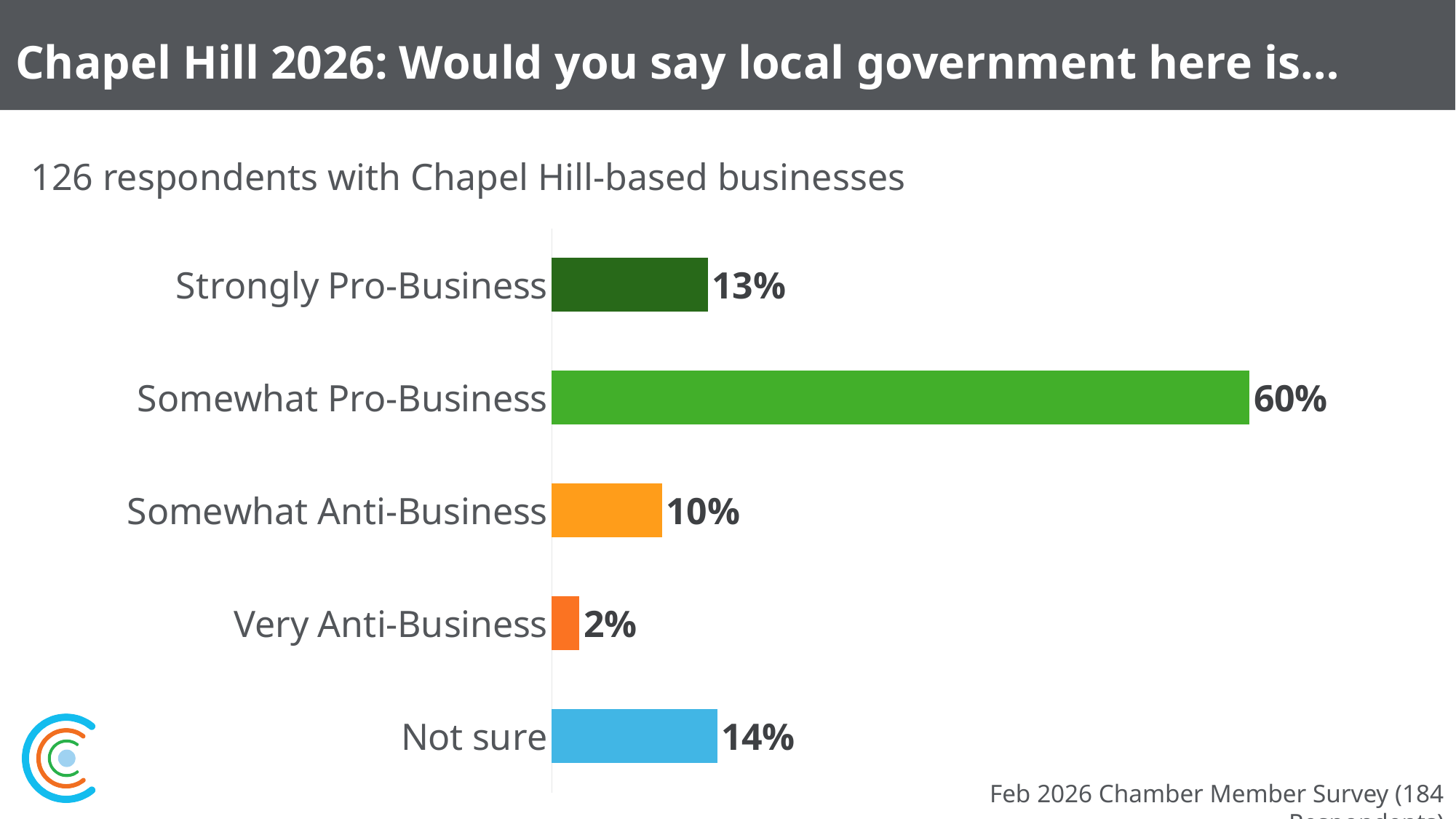
What colour is the bar for Not sure? Blue Which response category has the lowest percentage? Very Anti-Business What type of chart is shown on the slide? Bar chart Which is larger, the percentage for Not sure or the percentage for Strongly Pro-Business? Not sure What percentage of respondents said local government is Very Anti-Business? 2% Which response category has the highest percentage? Somewhat Pro-Business What percentage of respondents said local government is Strongly Pro-Business? 13% How many respondents with Chapel Hill-based businesses does the subtitle say answered this question? 126 What percentage of respondents said local government is Somewhat Pro-Business? 60% How many response categories are shown in the chart? 5 What percentage of respondents answered Not sure? 14% What is the difference in percentage points between Somewhat Pro-Business and Somewhat Anti-Business? 50